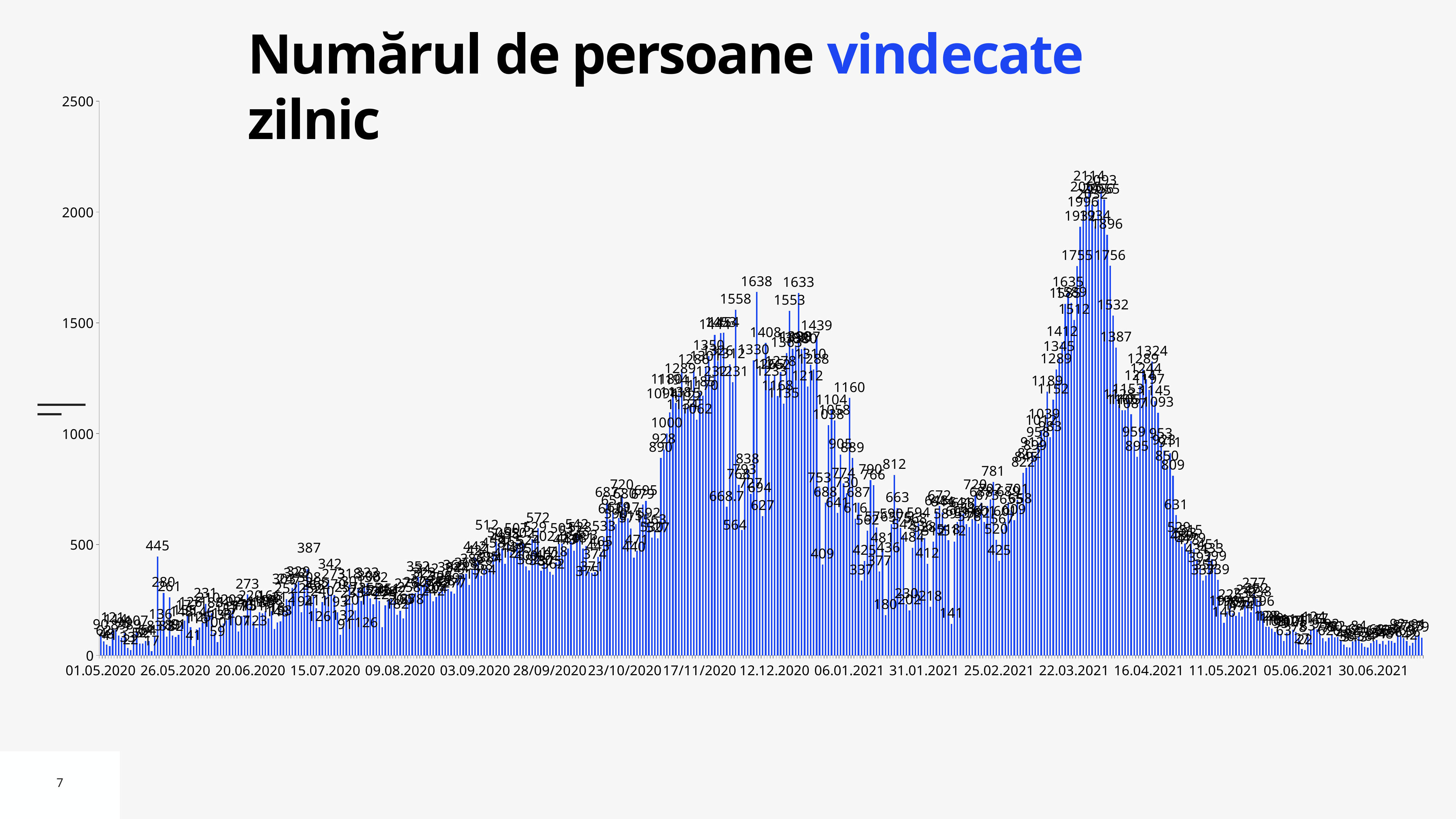
What is the highest data label printed on the chart? 2114 How many date labels are shown on the x axis? 18 Is the peak value near 22.03.2021 greater or less than 2000? greater Is the value at 30.06.2021 greater or less than 500? less Is the value at 01.05.2020 greater or less than 500? less What is the maximum value shown on the y axis? 2500 What kind of chart is shown on the slide? bar chart Do the values rise or fall between 22.03.2021 and 30.06.2021? fall Around which x-axis date does the chart reach its highest peak? between 22.03.2021 and 16.04.2021 Which wave has the higher peak: the one around December 2020 or the one around April 2021? April 2021 What is the title of the chart? Numărul de persoane vindecate zilnic